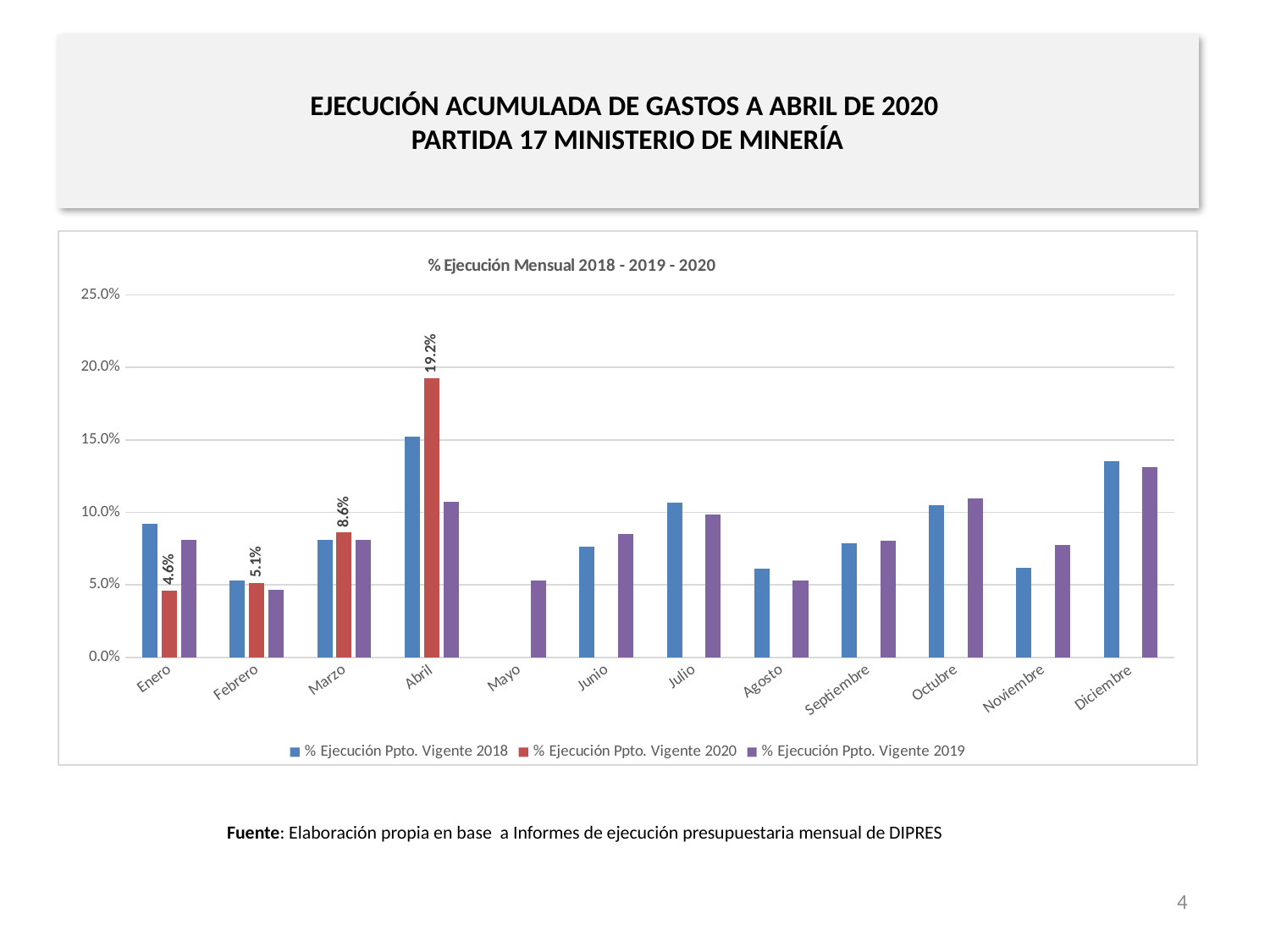
Do the values in the % Ejecución Ppto. Vigente 2020 series rise or fall from Enero to Abril? rise What is the value for Marzo in the % Ejecución Ppto. Vigente 2020 series? 8.6% Is the value for Mayo in the % Ejecución Ppto. Vigente 2019 series greater or less than 10.0%? less Which month has the highest value in the % Ejecución Ppto. Vigente 2020 series? Abril What is the difference between the 2020 values for Abril and Marzo? 10.6% What is the value for Enero in the % Ejecución Ppto. Vigente 2020 series? 4.6% Which month has the lowest value in the % Ejecución Ppto. Vigente 2020 series? Enero How many series does the legend list? 3 What is the value for Abril in the % Ejecución Ppto. Vigente 2020 series? 19.2% What is the difference between the 2020 values for Marzo and Febrero? 3.5% Is the value for Diciembre in the % Ejecución Ppto. Vigente 2018 series greater or less than 10.0%? greater For Abril, which series has the larger value: % Ejecución Ppto. Vigente 2018 or % Ejecución Ppto. Vigente 2020? % Ejecución Ppto. Vigente 2020